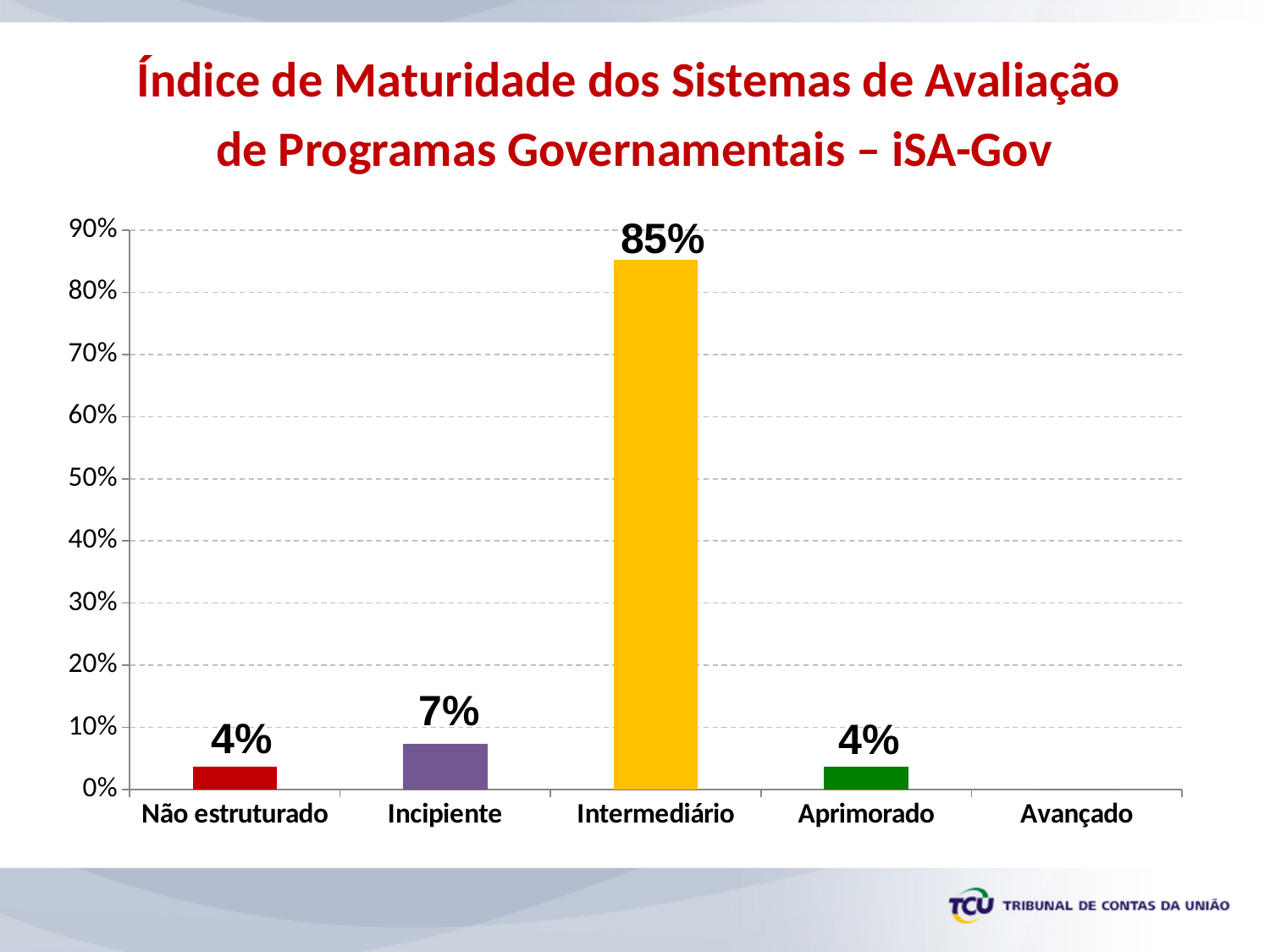
Is the value for Intermediário greater or less than 80%? greater What is the difference between the values for Intermediário and Incipiente? 78% How many categories are shown on the x axis? 5 Which category has the highest value? Intermediário What colour is the bar for Intermediário? yellow What is the value for Incipiente? 7% Which is larger, the value for Incipiente or the value for Não estruturado? Incipiente What is the difference between the values for Incipiente and Aprimorado? 3% What is the value for Aprimorado? 4% What kind of chart is shown on the slide? bar chart What is the value for Intermediário? 85% What is the value for Não estruturado? 4%